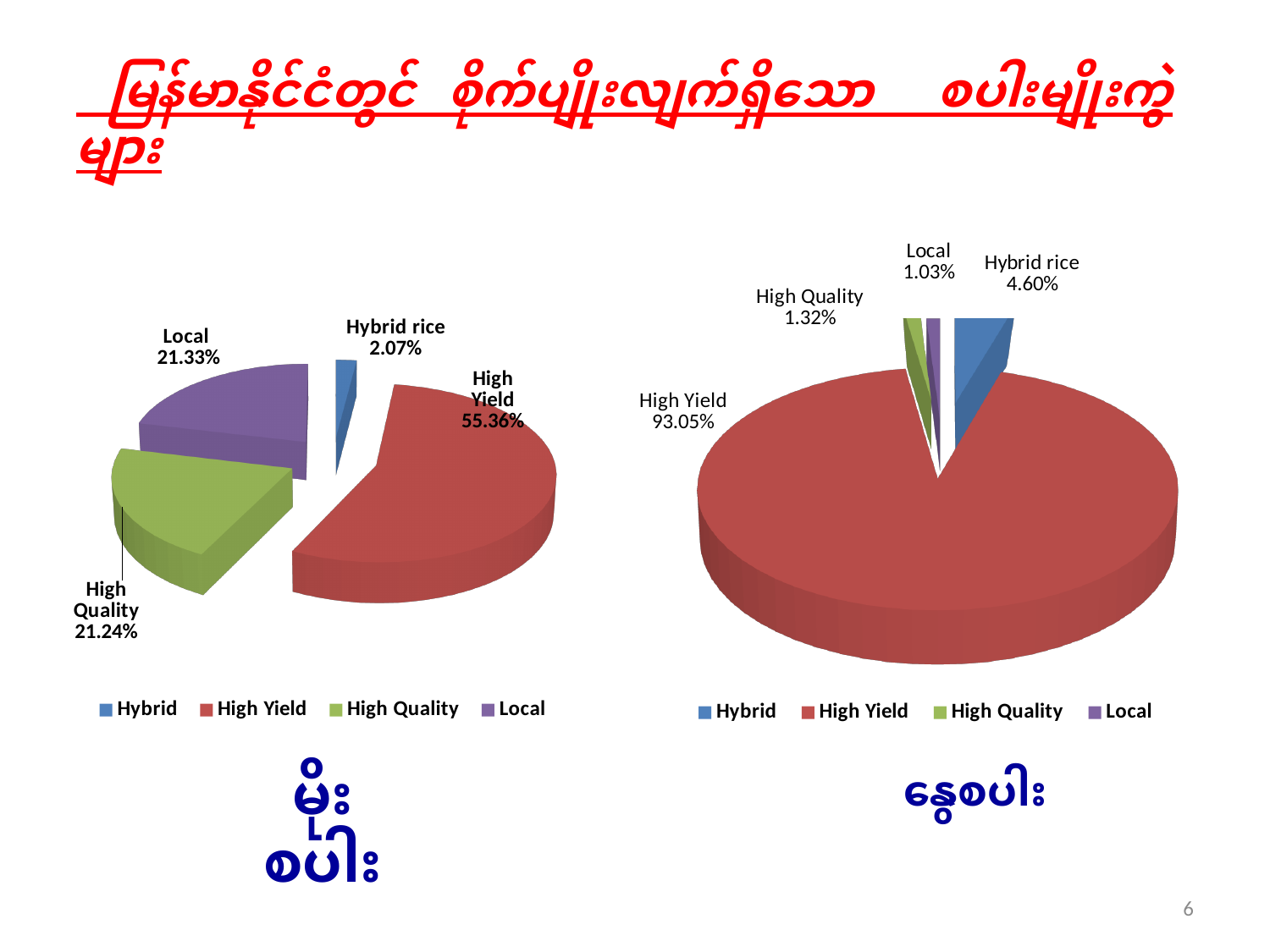
What type of chart is shown on the right side of the slide? Pie chart On the left pie chart, what is the value for Hybrid rice? 2.07% On the left pie chart, what is the difference between High Yield and High Quality? 34.12% On the left pie chart, which category has the smallest share? Hybrid rice On the right pie chart, what share does High Yield have? 93.05% On the right pie chart, which is larger, Hybrid rice or High Quality? Hybrid rice On the left pie chart, which category has the largest share? High Yield On the right pie chart, what is the value for Local? 1.03% How many slices does the left pie chart have? 4 On the right pie chart, what is the difference between Hybrid rice and High Quality? 3.28% On the right pie chart, which category has the smallest share? Local On the left pie chart, what share does High Yield have? 55.36%